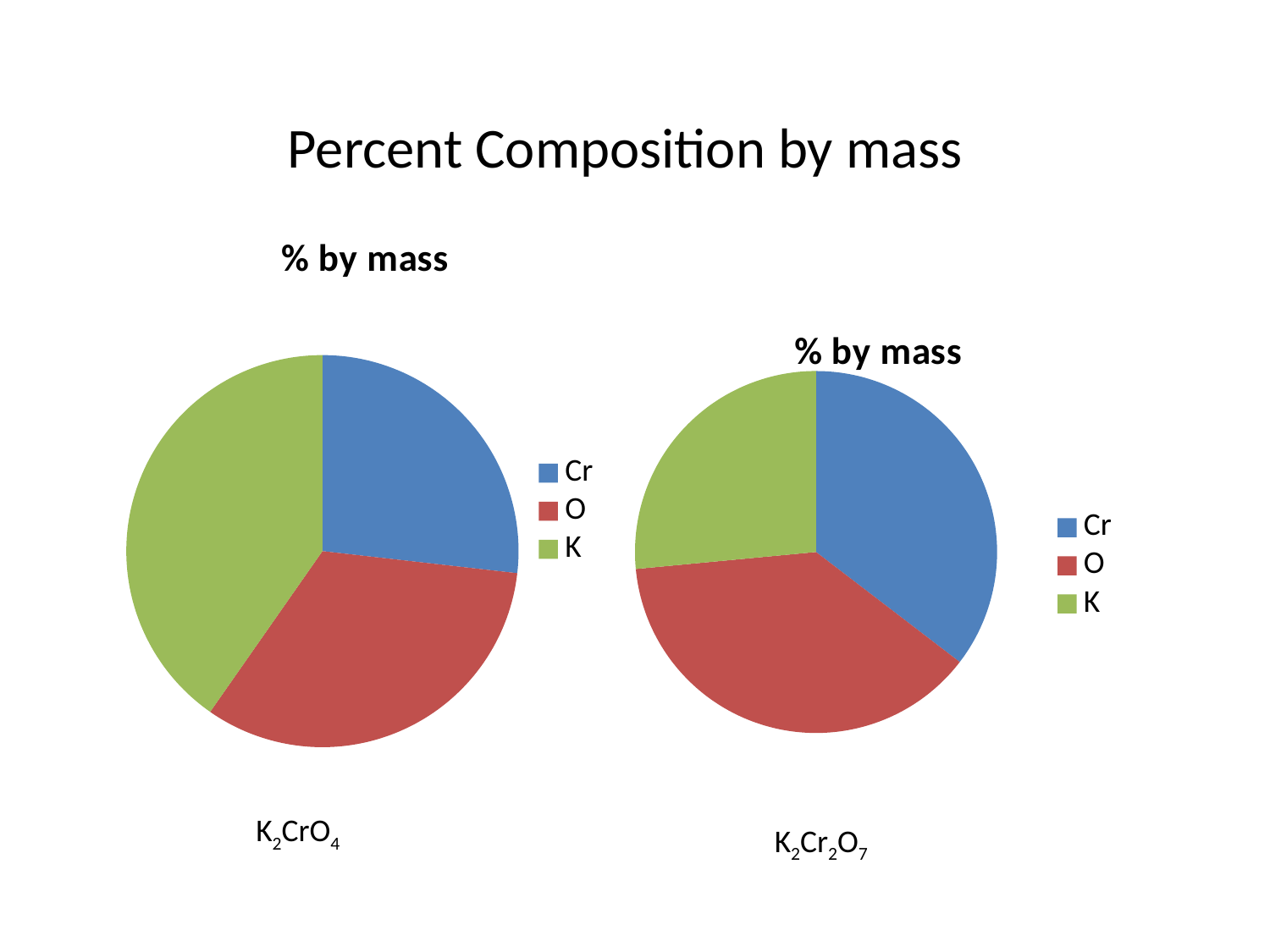
How many slices does the left pie chart (K2CrO4) have? 3 How many slices does the right pie chart (K2Cr2O7) have? 3 How many entries does the legend of the left pie chart (K2CrO4) list? 3 What kind of chart is the right chart labelled K2Cr2O7? Pie chart In the left pie chart (K2CrO4), which element has the largest slice? K What is the title shown above each pie chart? % by mass In the right pie chart (K2Cr2O7), which slice is larger, Cr or K? Cr In the legend of the right pie chart (K2Cr2O7), which colour represents O? Red What kind of chart is the left chart labelled K2CrO4? Pie chart In the right pie chart (K2Cr2O7), which element has the smallest slice? K In the left pie chart (K2CrO4), which slice is larger, K or Cr? K In the left pie chart (K2CrO4), which element has the smallest slice? Cr